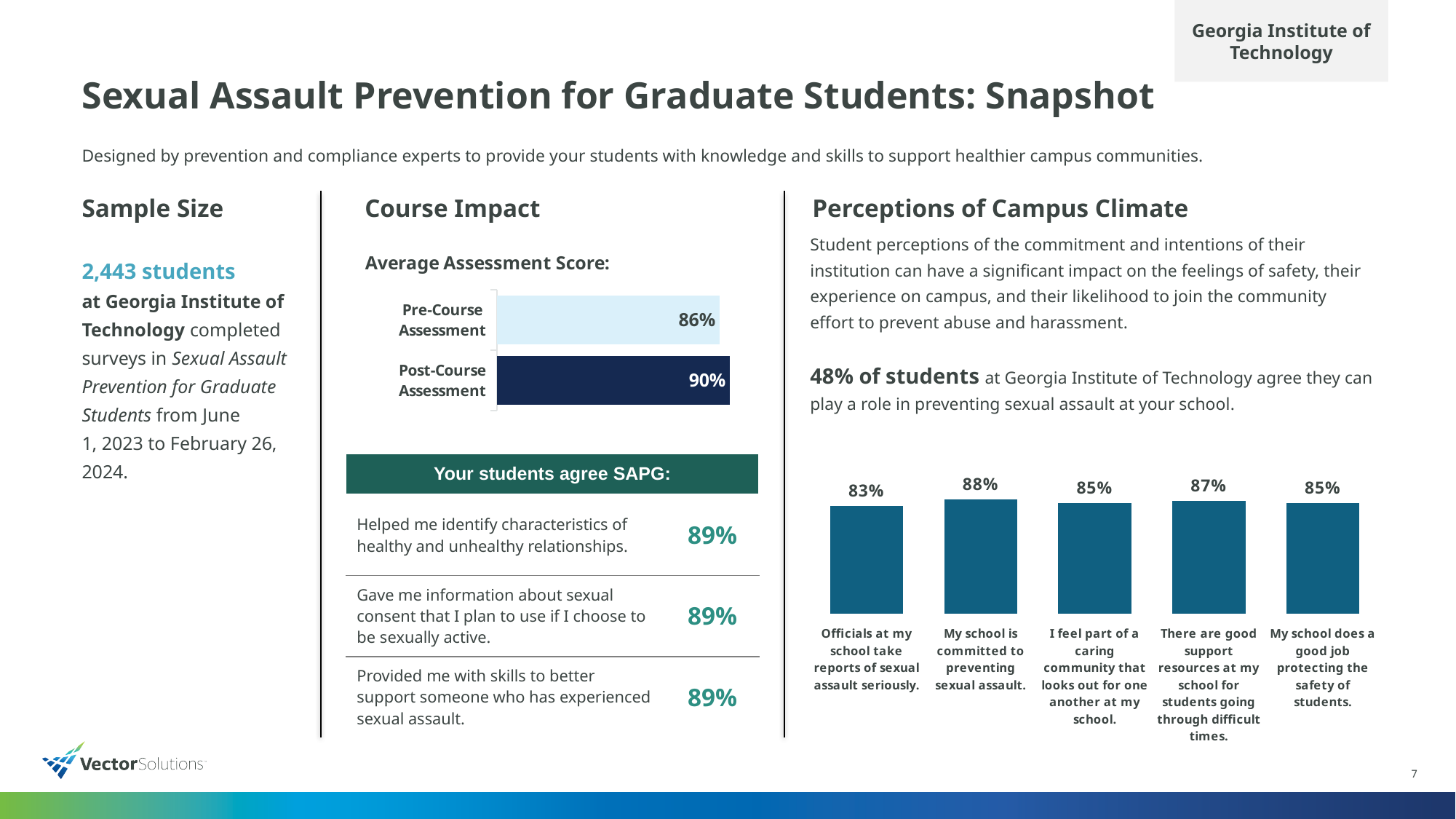
In the Average Assessment Score chart, which is larger, the Pre-Course or the Post-Course Assessment value? Post-Course Assessment In the Perceptions of Campus Climate chart, what is the value for 'Officials at my school take reports of sexual assault seriously.'? 83% In the Perceptions of Campus Climate chart, what is the difference between the highest and lowest values? 5% In the Perceptions of Campus Climate chart, what is the value for 'My school is committed to preventing sexual assault.'? 88% In the Perceptions of Campus Climate chart, which category has the highest value? My school is committed to preventing sexual assault. How many bars are in the Perceptions of Campus Climate chart? 5 In the Average Assessment Score chart, what is the difference between the Post-Course and Pre-Course Assessment values? 4% In the Average Assessment Score chart, what is the Post-Course Assessment value? 90% What kind of chart is the Average Assessment Score chart? Bar chart In the Perceptions of Campus Climate chart, which category has the lowest value? Officials at my school take reports of sexual assault seriously. In the Perceptions of Campus Climate chart, what is the value for 'There are good support resources at my school for students going through difficult times.'? 87% In the Average Assessment Score chart, what is the Pre-Course Assessment value? 86%